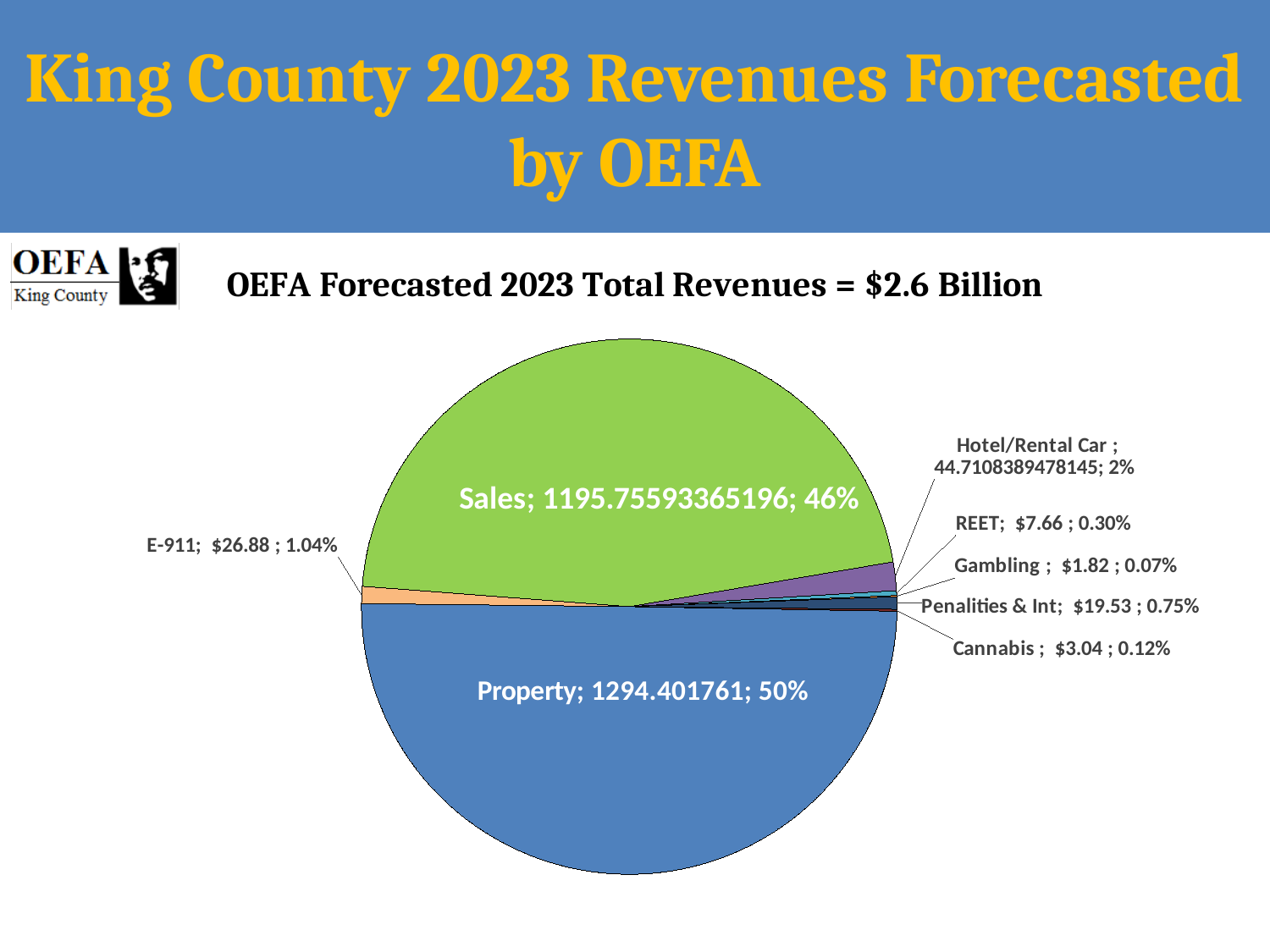
What total revenue figure is stated in the chart's heading? $2.6 Billion How many slices does the pie chart have? 8 Which is larger, the value for REET or the value for Cannabis? REET Which category has the smallest share of the pie? Gambling What share of the pie does Sales represent? 46% Which category has the largest share of the pie? Property What percentage is shown for Hotel/Rental Car? 2% What is the difference between the value for E-911 and the value for Penalities & Int? $7.35 What value is shown for Penalities & Int? $19.53 What kind of chart is shown on the slide? pie chart What value is shown for E-911? $26.88 What share of the pie does Property represent? 50%